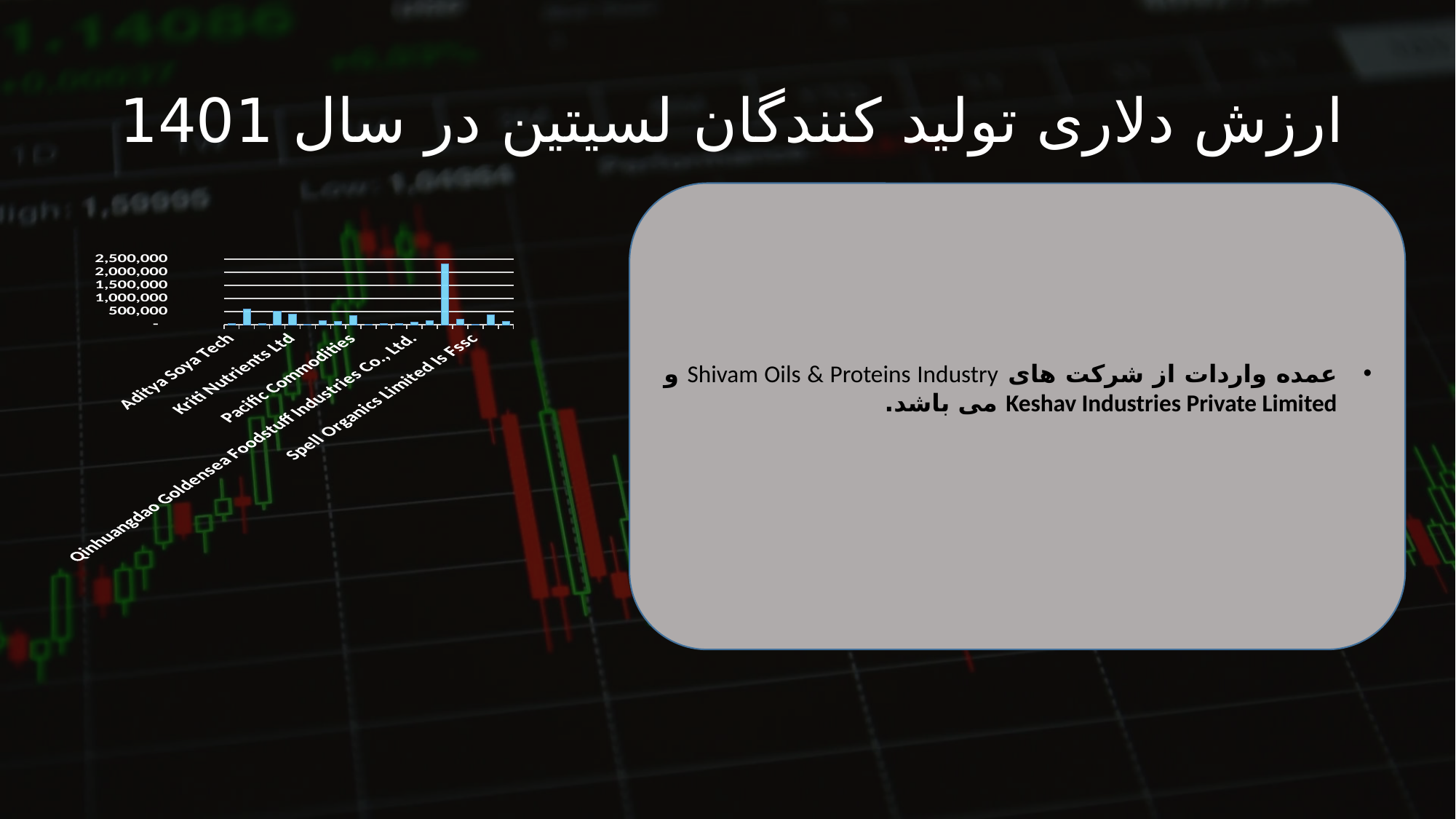
Which category label appears first (leftmost) on the horizontal axis of the chart? Aditya Soya Tech What is the highest value shown on the vertical axis of the chart? 2,500,000 Is the value for Aditya Soya Tech greater or less than 500,000? less Is the tallest bar in the chart greater or less than 2,000,000? greater What kind of chart is shown on the slide? bar chart